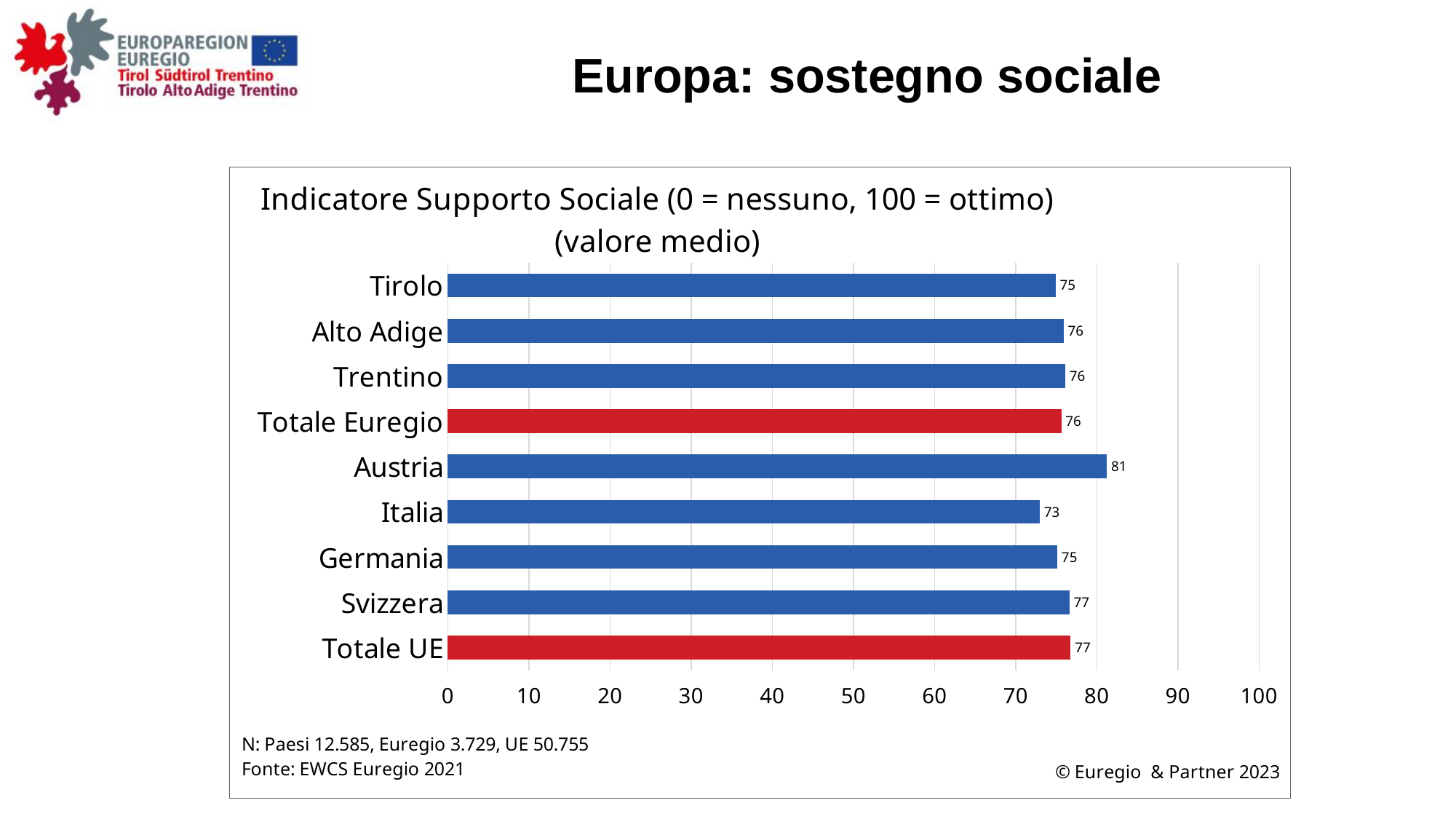
Which categories are shown with red bars? Totale Euregio and Totale UE What is the value for Austria? 81 What is the value for Totale UE? 77 What is the value for Italia? 73 Is the value for Austria greater or less than 80? greater Which is larger, the value for Svizzera or the value for Germania? Svizzera What is the difference between the values for Austria and Italia? 8 How many categories are shown in the chart? 9 Which category has the highest value? Austria Which category has the lowest value? Italia What kind of chart is shown on the slide? bar chart What is the value for Totale Euregio? 76